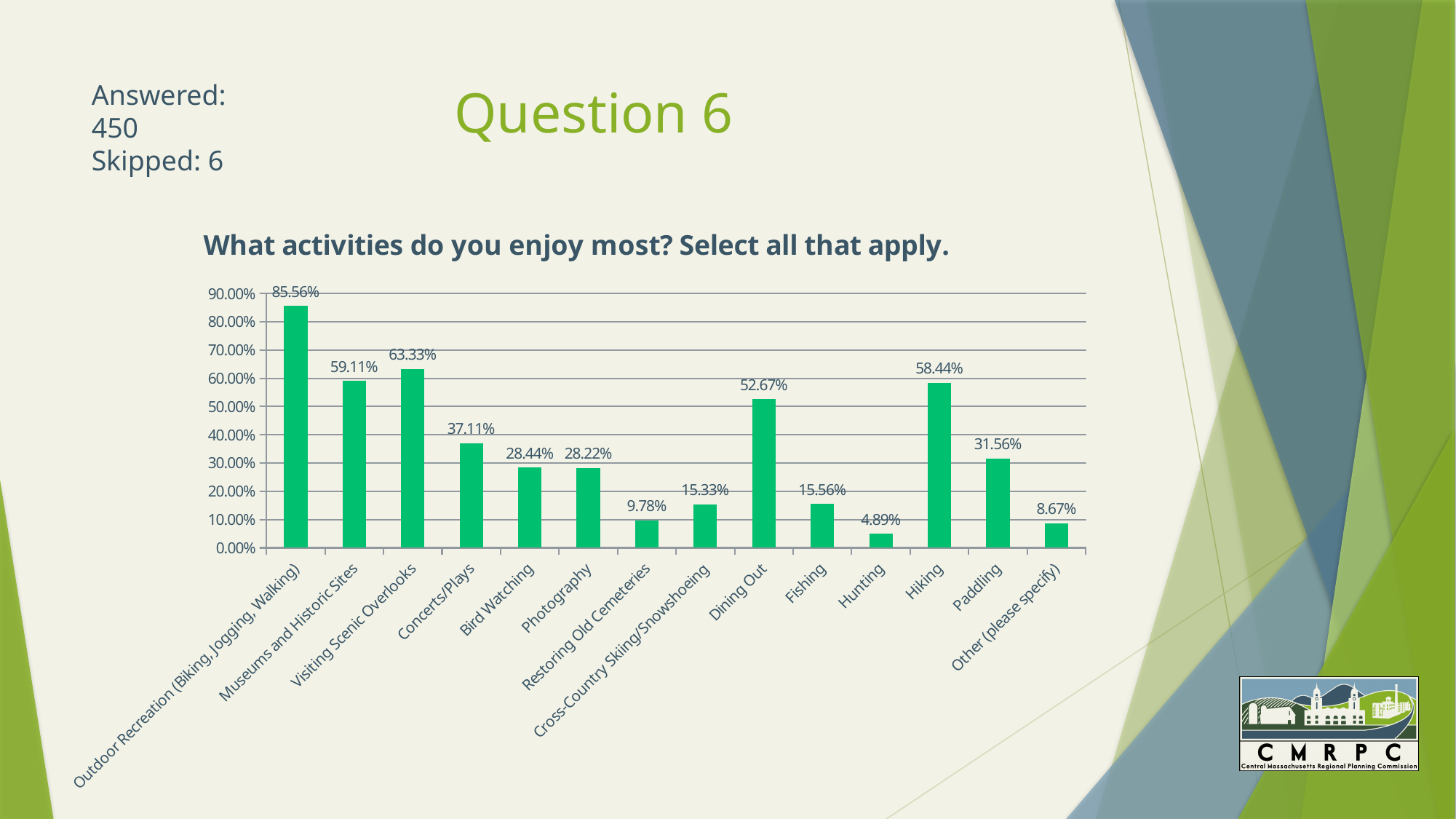
How many activity categories are shown on the chart? 14 Which is larger, the value for Visiting Scenic Overlooks or the value for Museums and Historic Sites? Visiting Scenic Overlooks What is the value for Concerts/Plays? 37.11% Which activity has the lowest value? Hunting What is the difference between the values for Hiking and Dining Out? 5.77% What is the value for Dining Out? 52.67% What is the value for Hiking? 58.44% What kind of chart is shown on the slide? bar chart What is the title of the chart? What activities do you enjoy most? Select all that apply. Is the value for Paddling greater or less than 30.00%? greater What is the value for Restoring Old Cemeteries? 9.78% Which activity has the highest value? Outdoor Recreation (Biking, Jogging, Walking)